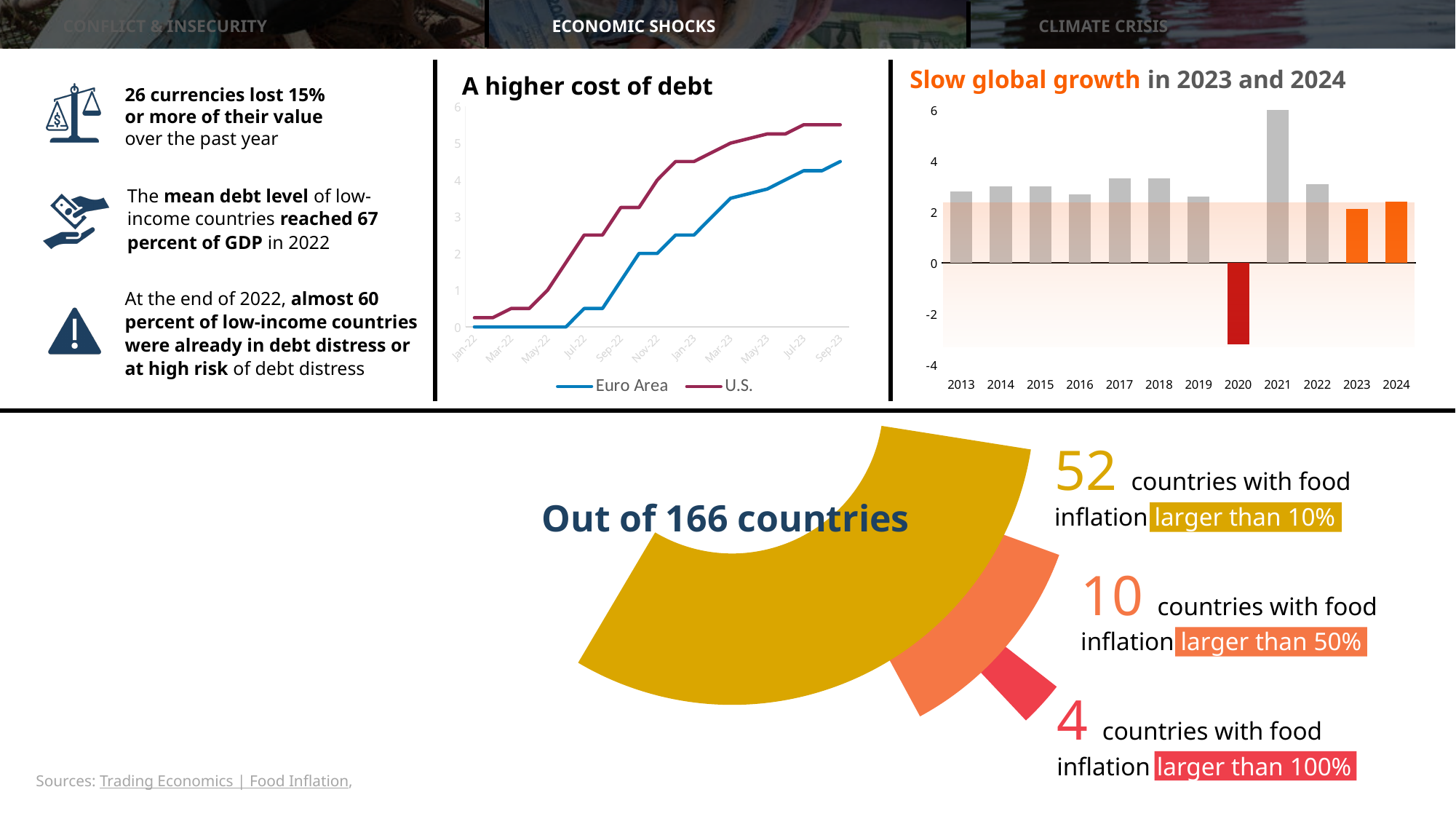
How many series does the legend of "A higher cost of debt" list? 2 In "Slow global growth in 2023 and 2024", which year has the highest value? 2021 In "A higher cost of debt", do the values for the U.S. rise or fall from Jan-22 to Sep-23? rise In "A higher cost of debt", is the U.S. value at Sep-23 greater or less than 5? greater In "Slow global growth in 2023 and 2024", which year has the lowest value? 2020 In "Slow global growth in 2023 and 2024", which year has the larger value, 2017 or 2019? 2017 How many years are shown on the x axis of "Slow global growth in 2023 and 2024"? 12 In "A higher cost of debt", which series is higher at Sep-23, Euro Area or U.S.? U.S. What kind of chart is "Slow global growth in 2023 and 2024"? bar chart In "Slow global growth in 2023 and 2024", is the value for 2020 greater or less than -2? less In "A higher cost of debt", is the Euro Area value at Jan-22 greater or less than 1? less What kind of chart is "A higher cost of debt"? line chart